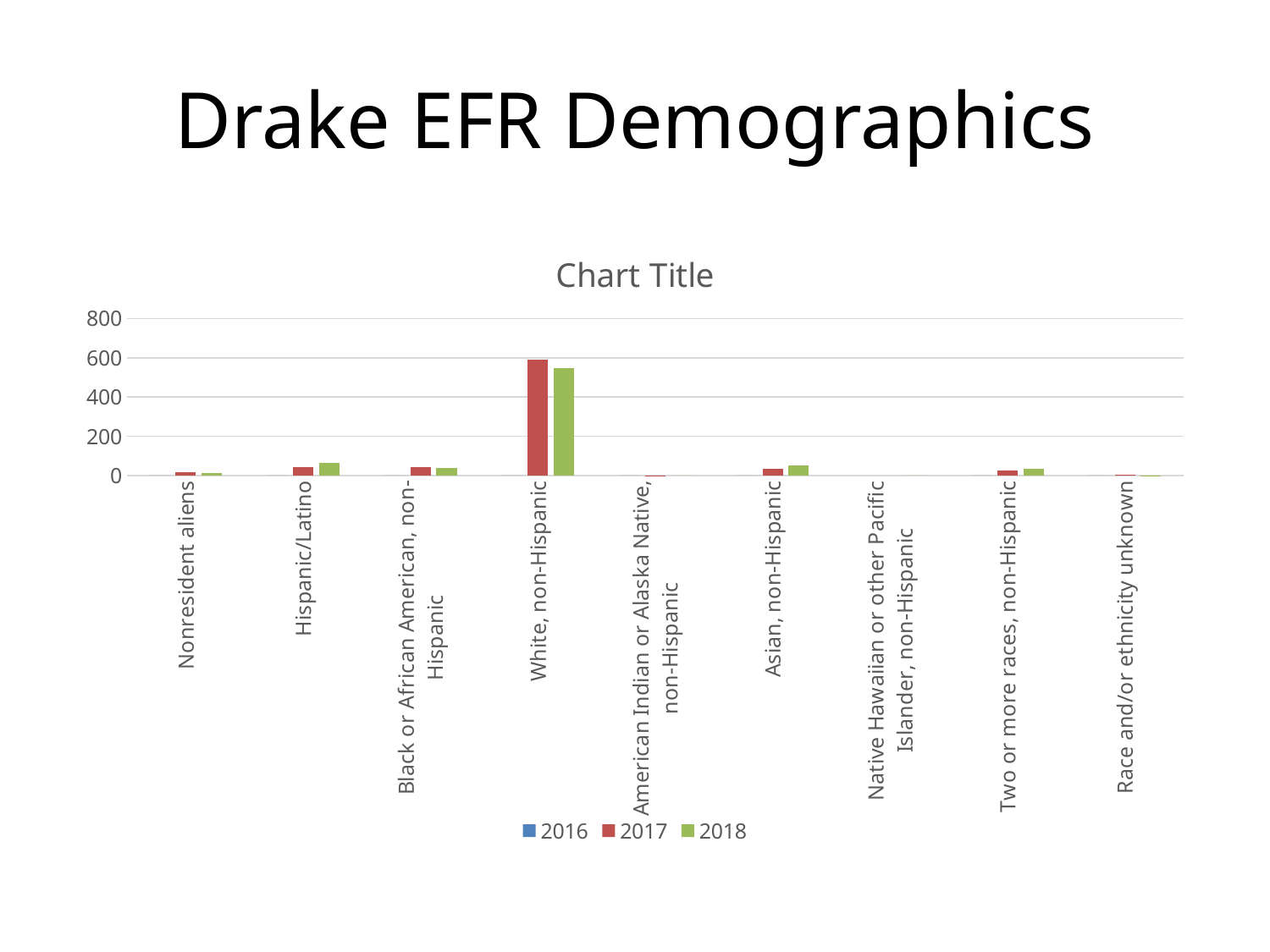
Which series are listed in the chart's legend? 2016, 2017, 2018 What kind of chart is shown on the slide? bar chart Is the 2017 value for Two or more races, non-Hispanic greater or less than 200? less How many categories are shown along the x axis of the chart? 9 Is the 2018 value for White, non-Hispanic greater or less than 400? greater For Asian, non-Hispanic, which year has the larger value, 2017 or 2018? 2018 Is the 2018 value for Hispanic/Latino greater or less than 200? less How many series does the chart's legend list? 3 Which category has the highest bars in the chart? White, non-Hispanic For White, non-Hispanic, which year has the larger value, 2017 or 2018? 2017 What is the title shown above the chart? Chart Title